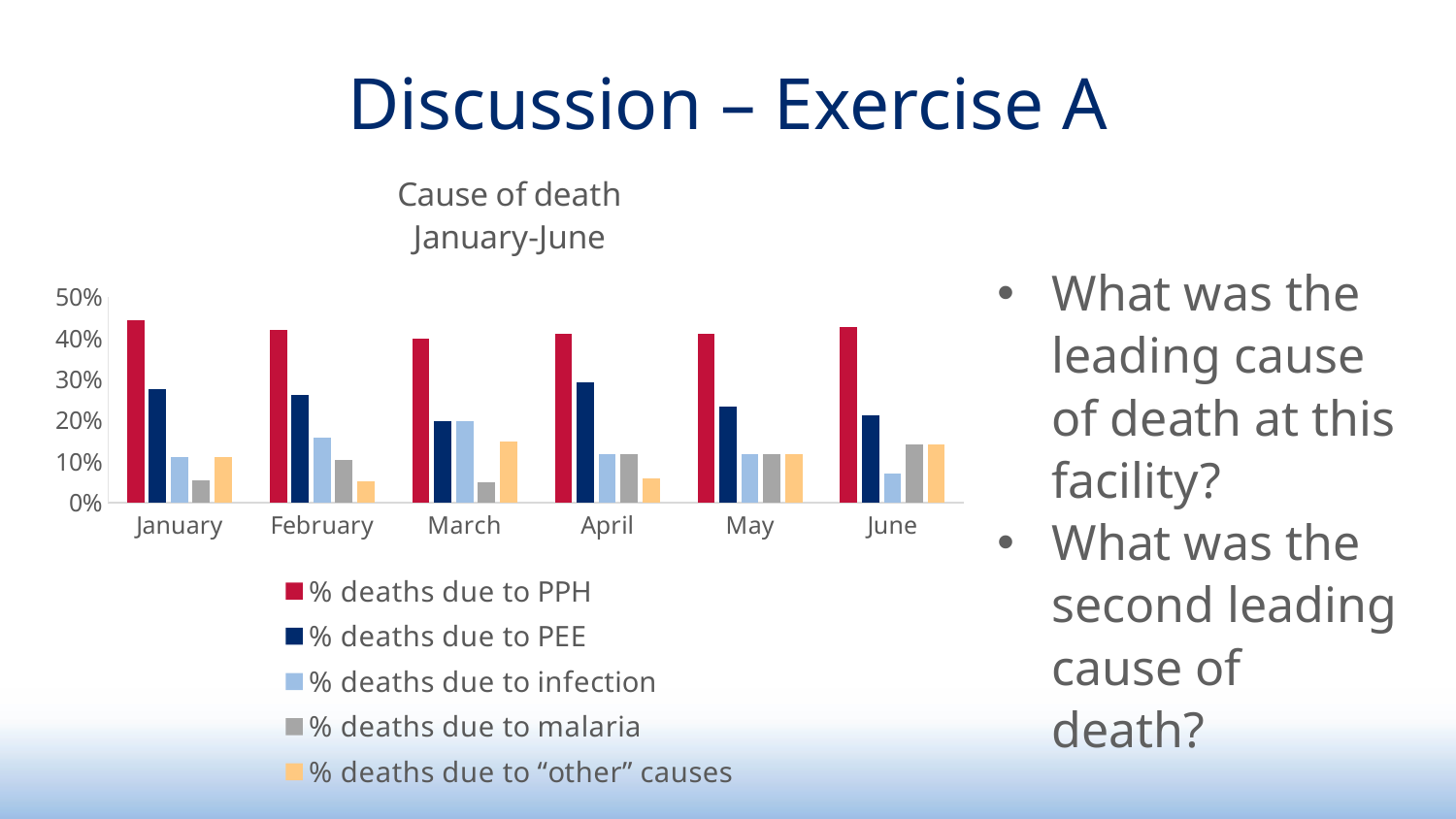
In March, which is larger: % deaths due to infection or % deaths due to malaria? % deaths due to infection How many series does the chart's legend list? 5 What kind of chart is shown on the slide? bar chart Is the value for % deaths due to infection in June greater or less than 10%? less How many months are shown on the x axis of the chart? 6 Which cause of death has the tallest bar in every month? % deaths due to PPH Is the value for % deaths due to malaria in January greater or less than 10%? less Is the value for % deaths due to infection in February greater or less than 10%? greater What is the title of the chart? Cause of death January-June In January, which is larger: % deaths due to PEE or % deaths due to infection? % deaths due to PEE